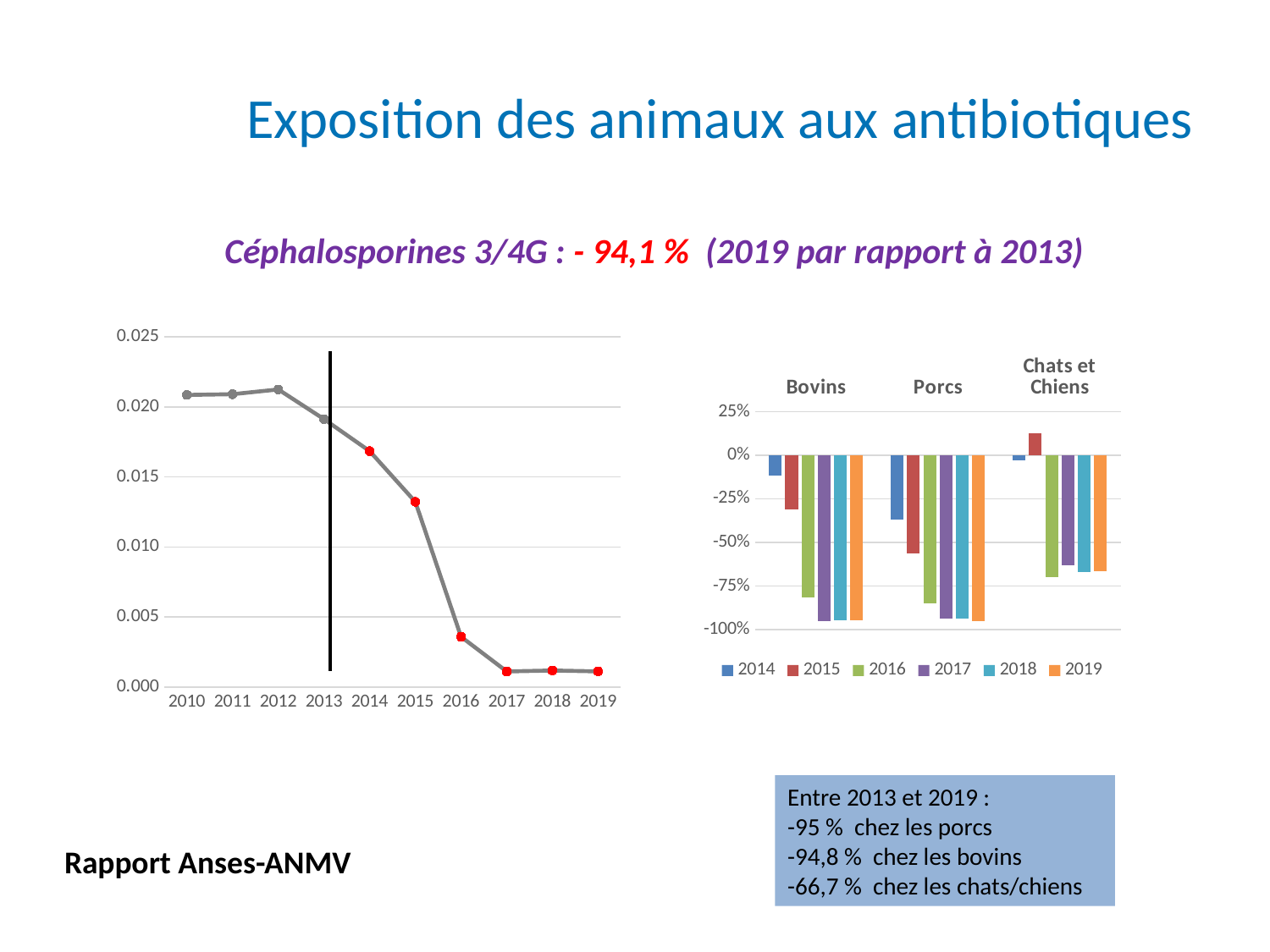
In the line chart on the left, do the values rise or fall from 2013 to 2019? fall In the line chart on the left, is the value for 2016 greater or less than 0.005? less What kind of chart is the chart on the right of the slide? bar chart In the bar chart on the right, is the 2015 value for Porcs greater or less than -50%? less In the bar chart on the right, how many series does the legend list? 6 In the line chart on the left, is the value for 2014 greater or less than 0.015? greater In the line chart on the left, how many years are shown on the x axis? 10 What kind of chart is the chart on the left of the slide? line chart In the bar chart on the right, how many categories are shown? 3 In the line chart on the left, which year has the highest value? 2012 In the line chart on the left, which is larger, the value for 2015 or the value for 2016? 2015 In the bar chart on the right, which category has a positive value for 2015? Chats et Chiens